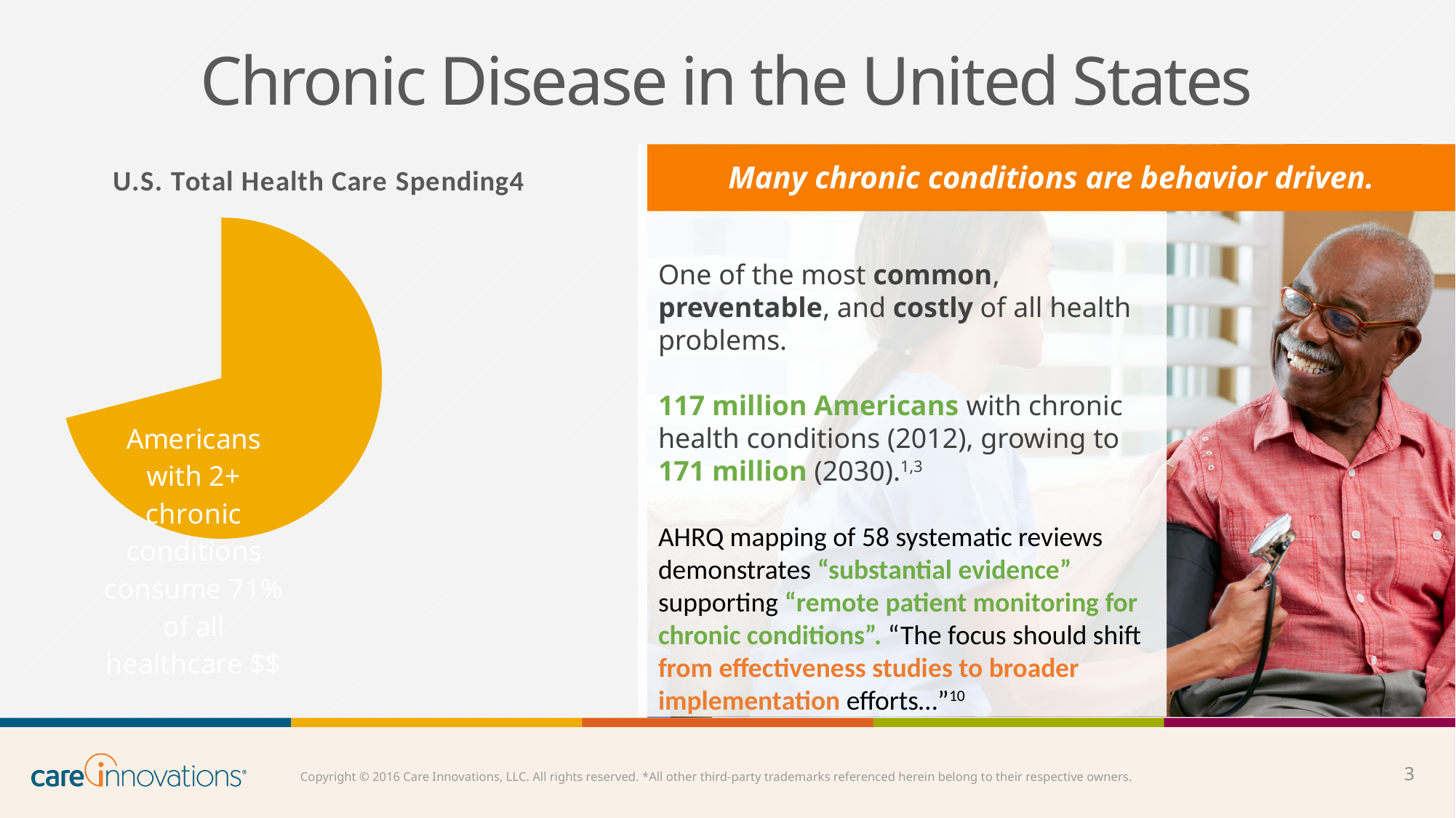
According to the pie chart, what share of all healthcare spending is consumed by Americans with 2+ chronic conditions? 71% What colour is the highlighted slice of the pie chart? yellow What is the title of the pie chart on the left of the slide? U.S. Total Health Care Spending4 Is the share of healthcare spending shown for Americans with 2+ chronic conditions greater or less than 50%? greater Which group does the highlighted slice of the pie chart represent? Americans with 2+ chronic conditions What kind of chart is shown under the heading "U.S. Total Health Care Spending4"? pie chart